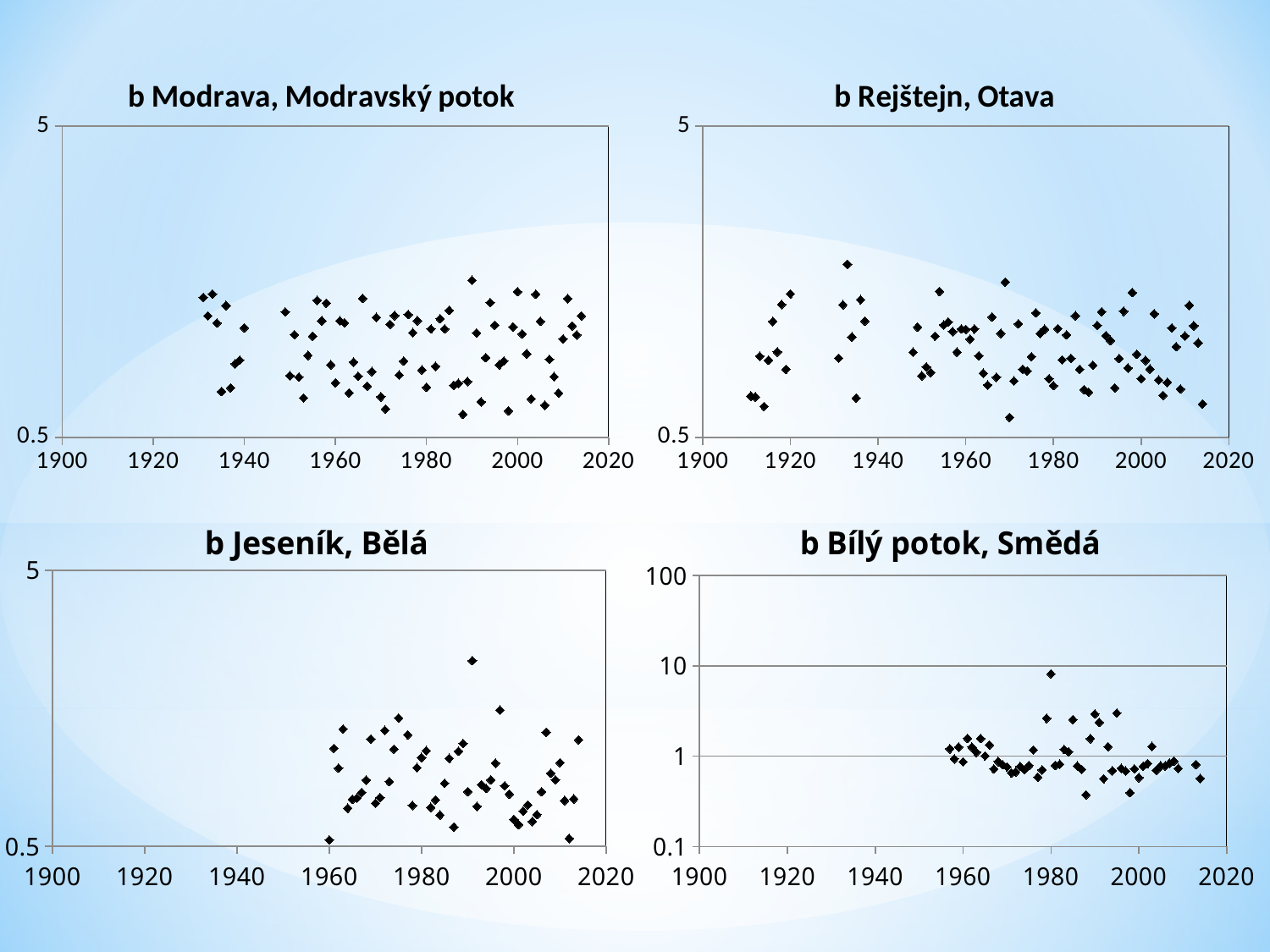
In the "b Bílý potok, Smědá" chart, is the highest point greater or less than 1? greater How many charts are shown on the slide? 4 In the "b Jeseník, Bělá" chart, is the highest point greater or less than 5? less In the "b Rejštejn, Otava" chart, is the lowest point greater or less than 0.5? greater Which chart on the slide contains data points from before 1920? b Rejštejn, Otava What is the range of the x axis on the "b Modrava, Modravský potok" chart? 1900 to 2020 What kind of chart is "b Modrava, Modravský potok"? scatter chart Which chart on the slide has a y axis running from 0.1 to 100? b Bílý potok, Smědá